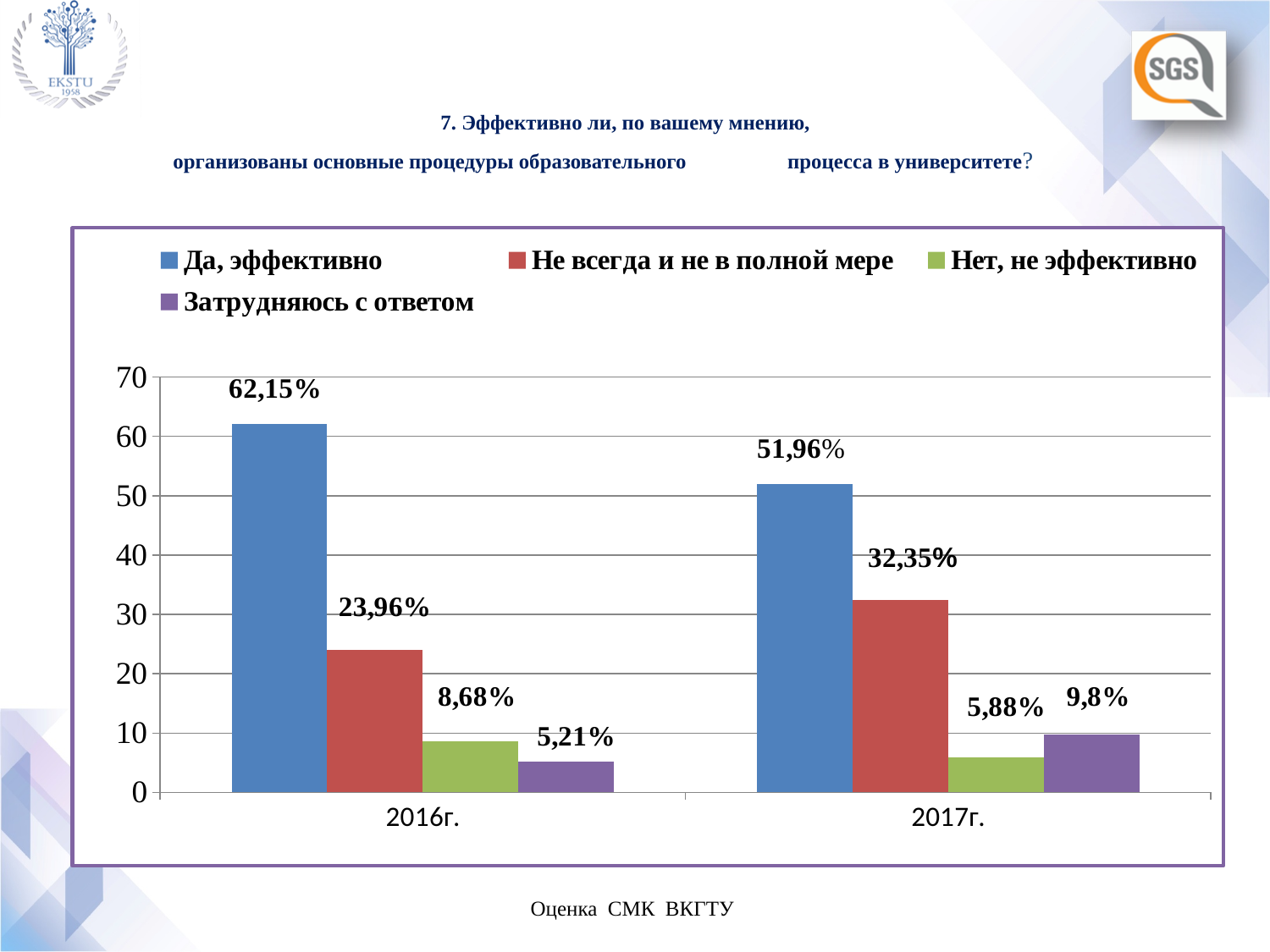
Which series has the lowest value in 2016г.? Затрудняюсь с ответом Which is larger: "Затрудняюсь с ответом" in 2016г. or in 2017г.? 2017г. What is the value for "Нет, не эффективно" in 2017г.? 5,88% What is the difference between the "Да, эффективно" values for 2016г. and 2017г.? 10,19% How many series does the legend list? 4 What is the value for "Да, эффективно" in 2016г.? 62,15% What is the value for "Затрудняюсь с ответом" in 2016г.? 5,21% Which series has the highest value in 2017г.? Да, эффективно Does the value for "Да, эффективно" fall or rise from 2016г. to 2017г.? fall How many categories are shown on the x axis? 2 What is the value for "Не всегда и не в полной мере" in 2017г.? 32,35% What kind of chart is shown on the slide? bar chart